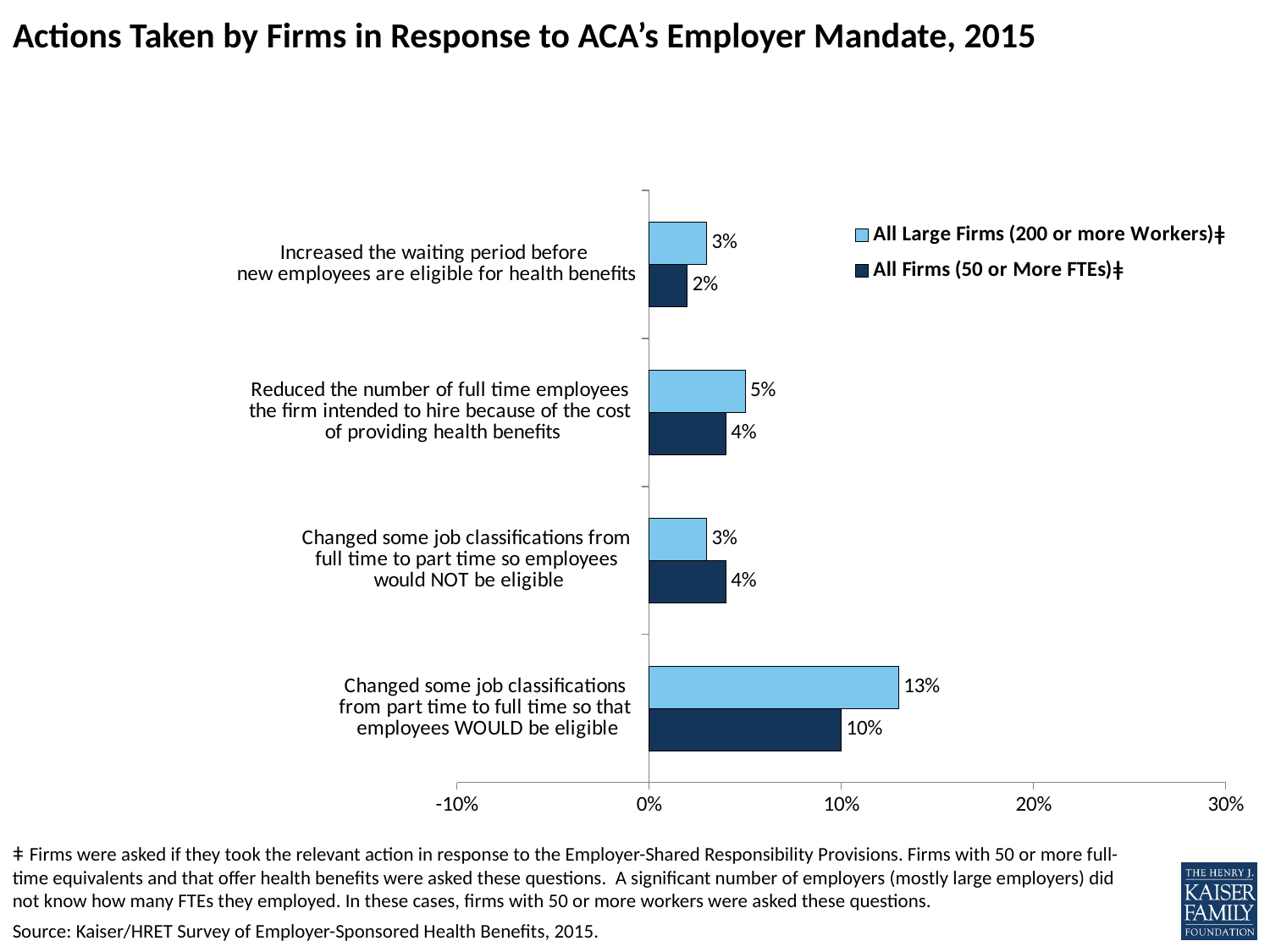
Is the value for All Firms (50 or More FTEs) changing job classifications from part time to full time greater or less than 20%? less How many series does the legend list? 2 What percentage of All Large Firms (200 or more Workers) changed some job classifications from part time to full time so that employees WOULD be eligible? 13% What is the title of the chart? Actions Taken by Firms in Response to ACA's Employer Mandate, 2015 What percentage of All Firms (50 or More FTEs) reduced the number of full time employees the firm intended to hire because of the cost of providing health benefits? 4% How many actions (categories) are shown on the chart? 4 What is the difference between All Large Firms and All Firms for changing job classifications from part time to full time so that employees WOULD be eligible? 3 percentage points Which action has the highest value for All Large Firms (200 or more Workers)? Changed some job classifications from part time to full time so that employees WOULD be eligible What percentage of All Firms (50 or More FTEs) increased the waiting period before new employees are eligible for health benefits? 2% Which action has the lowest value for All Firms (50 or More FTEs)? Increased the waiting period before new employees are eligible for health benefits What kind of chart is shown on the slide? Bar chart For changing some job classifications from full time to part time so employees would NOT be eligible, which series has the larger value: All Large Firms (200 or more Workers) or All Firms (50 or More FTEs)? All Firms (50 or More FTEs)